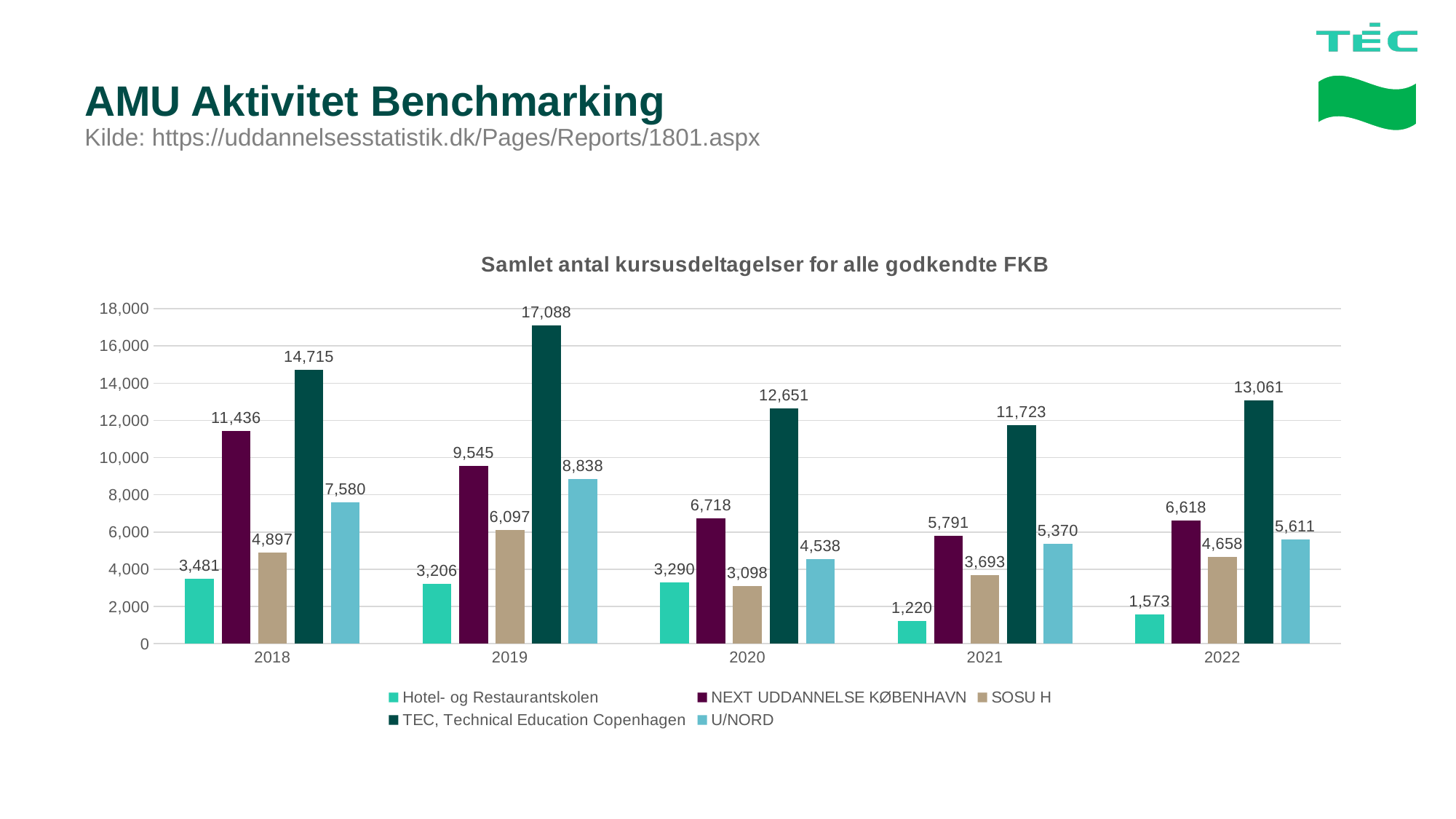
Which series has the lowest value in 2022? Hotel- og Restaurantskolen What is the value for U/NORD in 2022? 5,611 What is the value for SOSU H in 2020? 3,098 What type of chart is shown on the slide? bar chart How many years are shown on the x axis? 5 What is the title of the chart? Samlet antal kursusdeltagelser for alle godkendte FKB What is the difference between the TEC, Technical Education Copenhagen values in 2019 and 2018? 2,373 Which series has the highest value in 2021? TEC, Technical Education Copenhagen Which is larger in 2018: the value for NEXT UDDANNELSE KØBENHAVN or the value for U/NORD? NEXT UDDANNELSE KØBENHAVN What is the value for TEC, Technical Education Copenhagen in 2019? 17,088 Does the value for NEXT UDDANNELSE KØBENHAVN rise or fall from 2018 to 2021? fall How many series does the legend list? 5